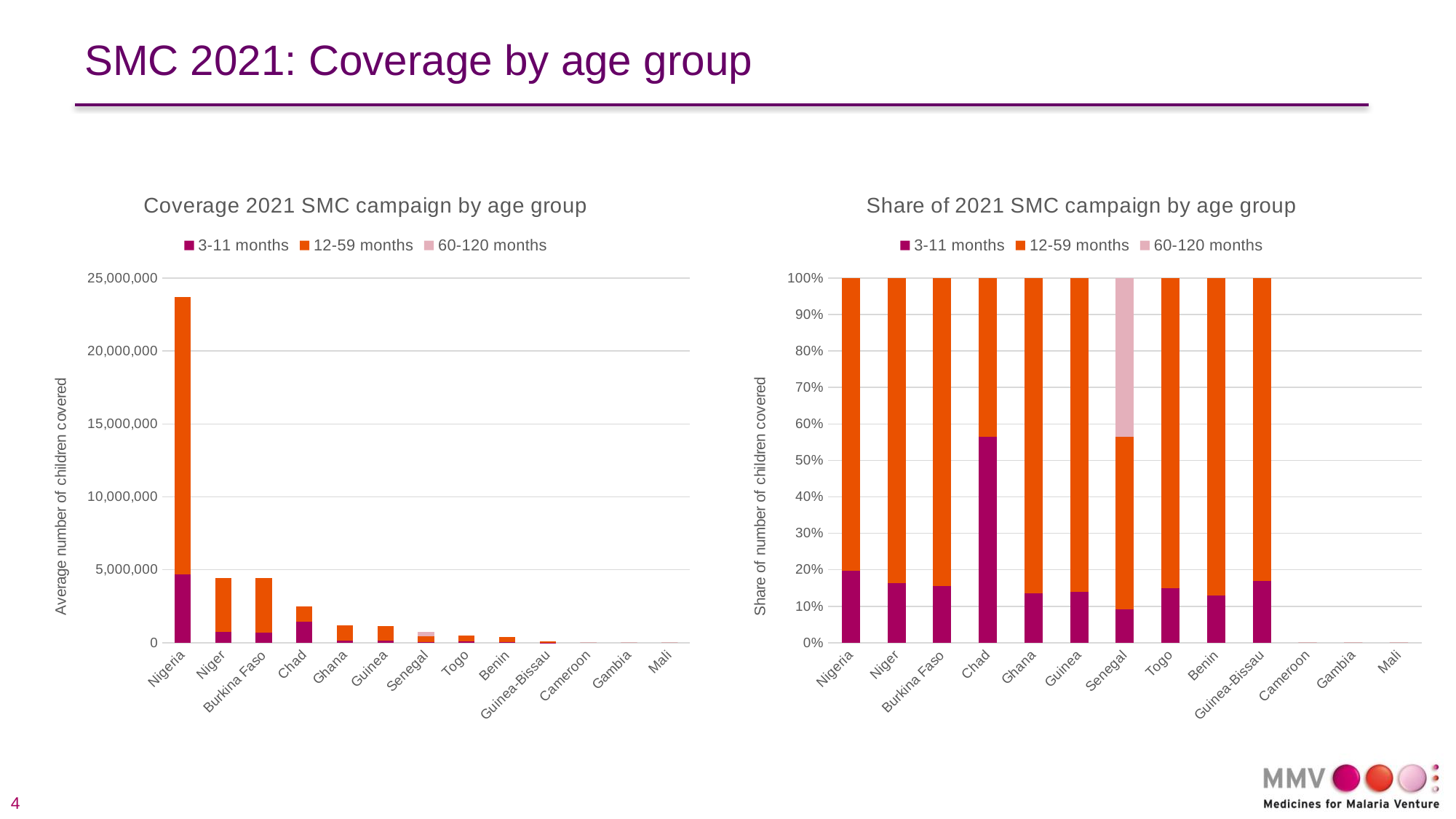
In the 'Coverage 2021 SMC campaign by age group' chart, is the total bar for Nigeria greater or less than 20,000,000? greater In the 'Share of 2021 SMC campaign by age group' chart, is the 3-11 months share for Nigeria greater or less than 10%? greater How many series does the legend of the 'Share of 2021 SMC campaign by age group' chart list? 3 In the 'Share of 2021 SMC campaign by age group' chart, which country has the largest 3-11 months share? Chad What kind of chart is the 'Coverage 2021 SMC campaign by age group' chart on the left? Stacked bar chart How many countries are shown on the x axis of the 'Coverage 2021 SMC campaign by age group' chart? 13 In the 'Coverage 2021 SMC campaign by age group' chart, is the total bar for Niger greater or less than 5,000,000? less In the 'Coverage 2021 SMC campaign by age group' chart, which country has the tallest bar? Nigeria In the 'Coverage 2021 SMC campaign by age group' chart, which has a taller bar, Chad or Ghana? Chad What is the y-axis label of the 'Coverage 2021 SMC campaign by age group' chart? Average number of children covered In the 'Share of 2021 SMC campaign by age group' chart, which country shows a visible 60-120 months segment? Senegal